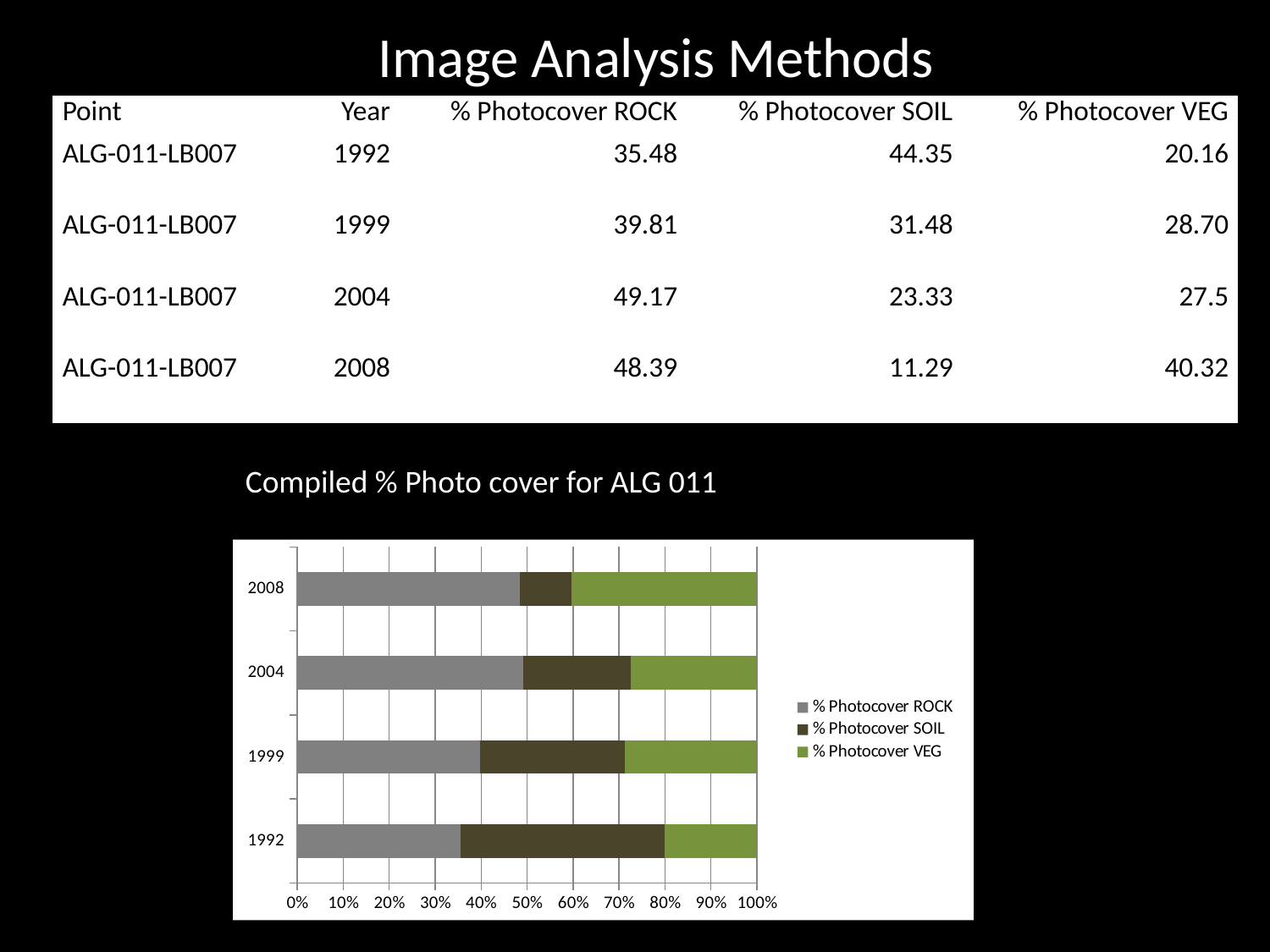
Is the % Photocover ROCK value for 1992 greater or less than 30%? greater Which is larger, the % Photocover VEG segment for 2008 or for 1992? 2008 What is the title shown above the chart? Compiled % Photo cover for ALG 011 Which year has the smallest % Photocover SOIL segment? 2008 Is the % Photocover VEG value for 2008 greater or less than 30%? greater Which year has the largest % Photocover SOIL segment? 1992 What kind of chart is shown under the heading 'Compiled % Photo cover for ALG 011'? stacked bar chart How many series does the chart legend list? 3 Does the % Photocover SOIL share rise or fall from 1992 to 2008? fall Is the % Photocover SOIL value for 2008 greater or less than 20%? less How many years are plotted on the chart? 4 Which series is shown in green on the chart? % Photocover VEG